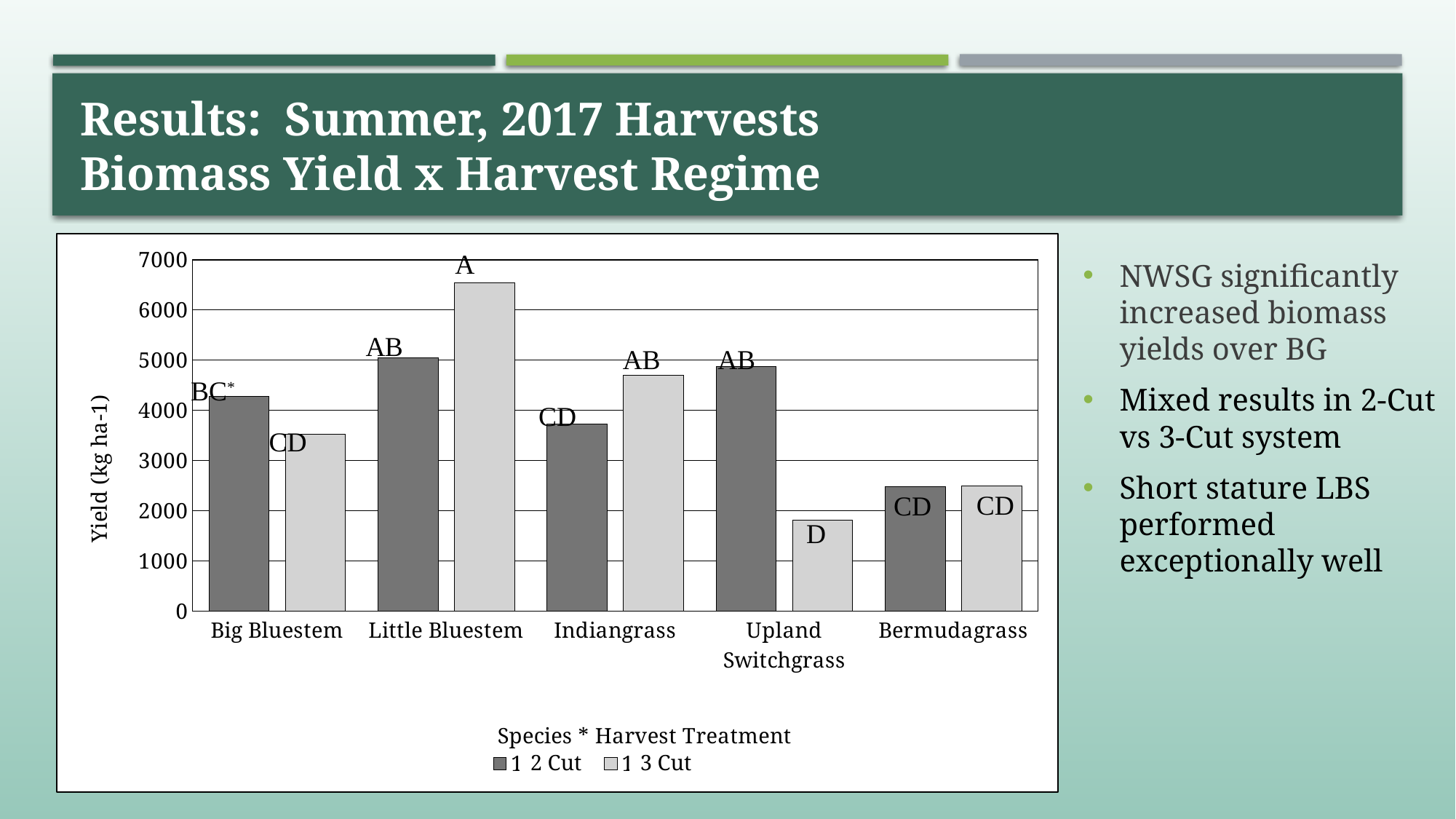
Which species and harvest treatment has the highest yield? Little Bluestem, 3 Cut What kind of chart is shown on the slide? bar chart How many species categories are shown on the x axis? 5 Is the 2 Cut yield for Indiangrass greater or less than 4000? less What letter label is printed above the 3 Cut bar for Little Bluestem? A What is the y-axis title of the chart? Yield (kg ha-1) Is the 3 Cut yield for Upland Switchgrass greater or less than 2000? less For Upland Switchgrass, which harvest treatment gives the larger yield, 2 Cut or 3 Cut? 2 Cut Is the 3 Cut yield for Little Bluestem greater or less than 6000? greater How many series does the legend list? 2 For Indiangrass, which harvest treatment gives the larger yield, 2 Cut or 3 Cut? 3 Cut Which species and harvest treatment has the lowest yield? Upland Switchgrass, 3 Cut